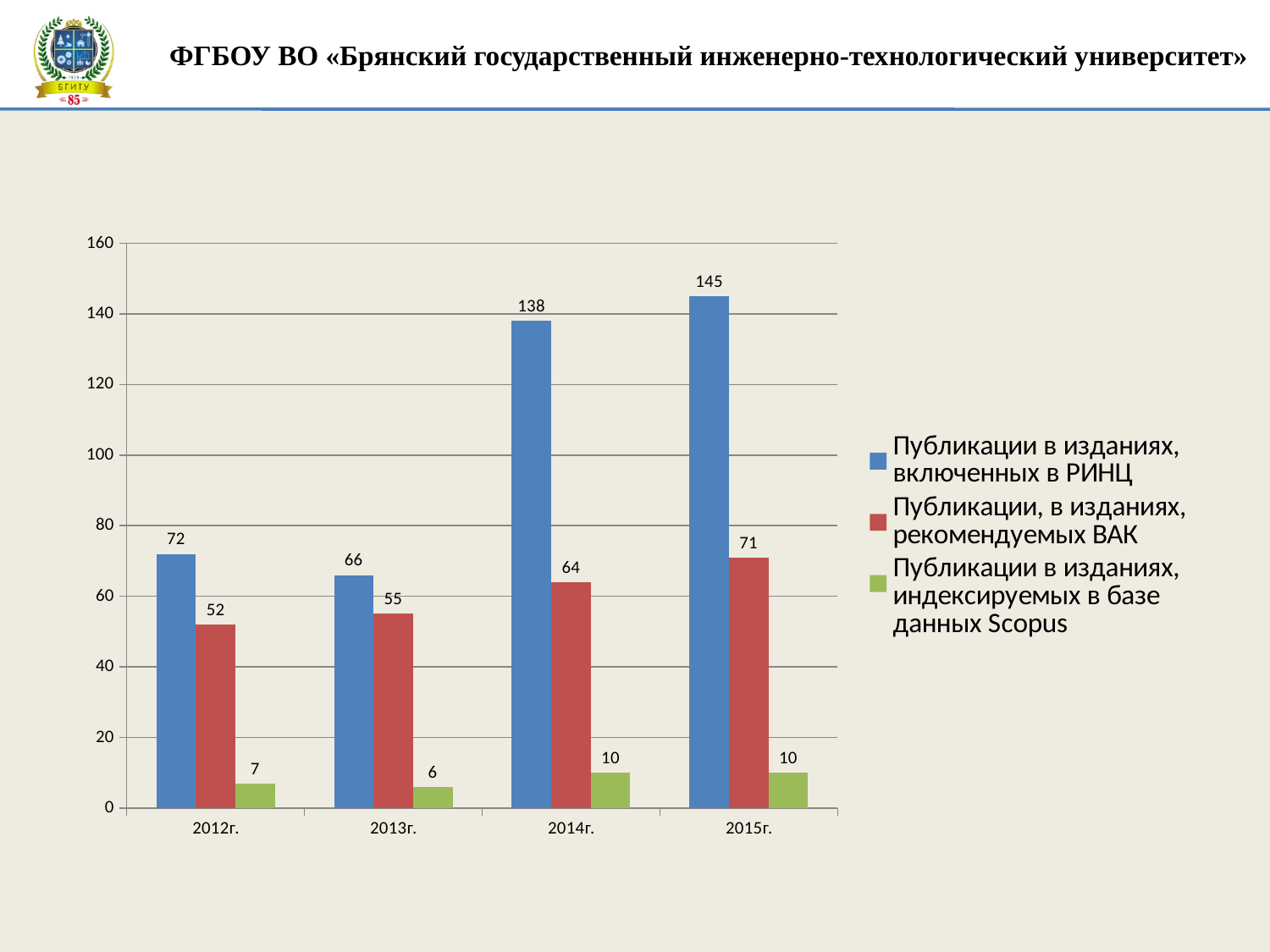
In which year is the value for 'Публикации в изданиях, включенных в РИНЦ' highest? 2015г. What is the value for 'Публикации в изданиях, включенных в РИНЦ' in 2014г.? 138 What kind of chart is shown on the slide? bar chart How many years are shown on the x axis? 4 What is the difference between the 'Публикации в изданиях, включенных в РИНЦ' values for 2015г. and 2012г.? 73 What is the value for 'Публикации в изданиях, индексируемых в базе данных Scopus' in 2012г.? 7 Is the value for 'Публикации в изданиях, включенных в РИНЦ' in 2013г. greater or less than 80? less What is the value for 'Публикации, в изданиях, рекомендуемых ВАК' in 2013г.? 55 Does the value for 'Публикации, в изданиях, рекомендуемых ВАК' rise or fall from 2012г. to 2015г.? rise How many series does the legend list? 3 In which year is the value for 'Публикации в изданиях, индексируемых в базе данных Scopus' lowest? 2013г. Which is larger: the 'Публикации, в изданиях, рекомендуемых ВАК' value for 2014г. or for 2015г.? 2015г.